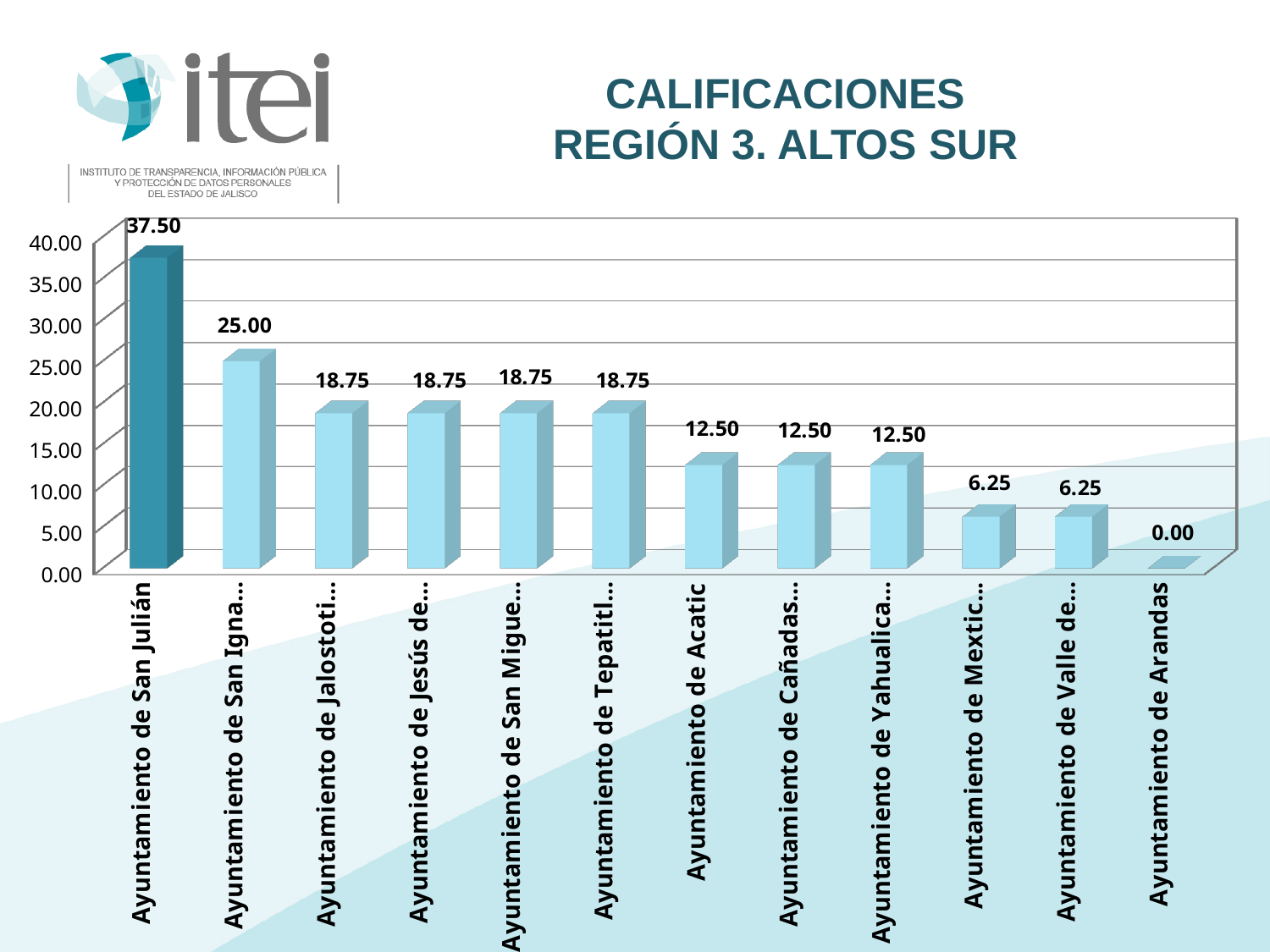
What is the title shown above the chart? CALIFICACIONES REGIÓN 3. ALTOS SUR What is the value for Ayuntamiento de Acatic? 12.50 What kind of chart is shown on the slide? bar chart Do the values rise or fall from left to right along the x axis? fall Which category has the lowest value? Ayuntamiento de Arandas What is the value for Ayuntamiento de San Julián? 37.50 Which is larger, the value for Ayuntamiento de San Julián or the value for Ayuntamiento de Acatic? Ayuntamiento de San Julián What is the value for Ayuntamiento de Arandas? 0.00 Which category has the highest value? Ayuntamiento de San Julián What is the difference between the values for Ayuntamiento de San Julián and Ayuntamiento de Acatic? 25.00 How many categories are shown on the x axis? 12 Is the value for Ayuntamiento de Acatic greater or less than 20.00? less